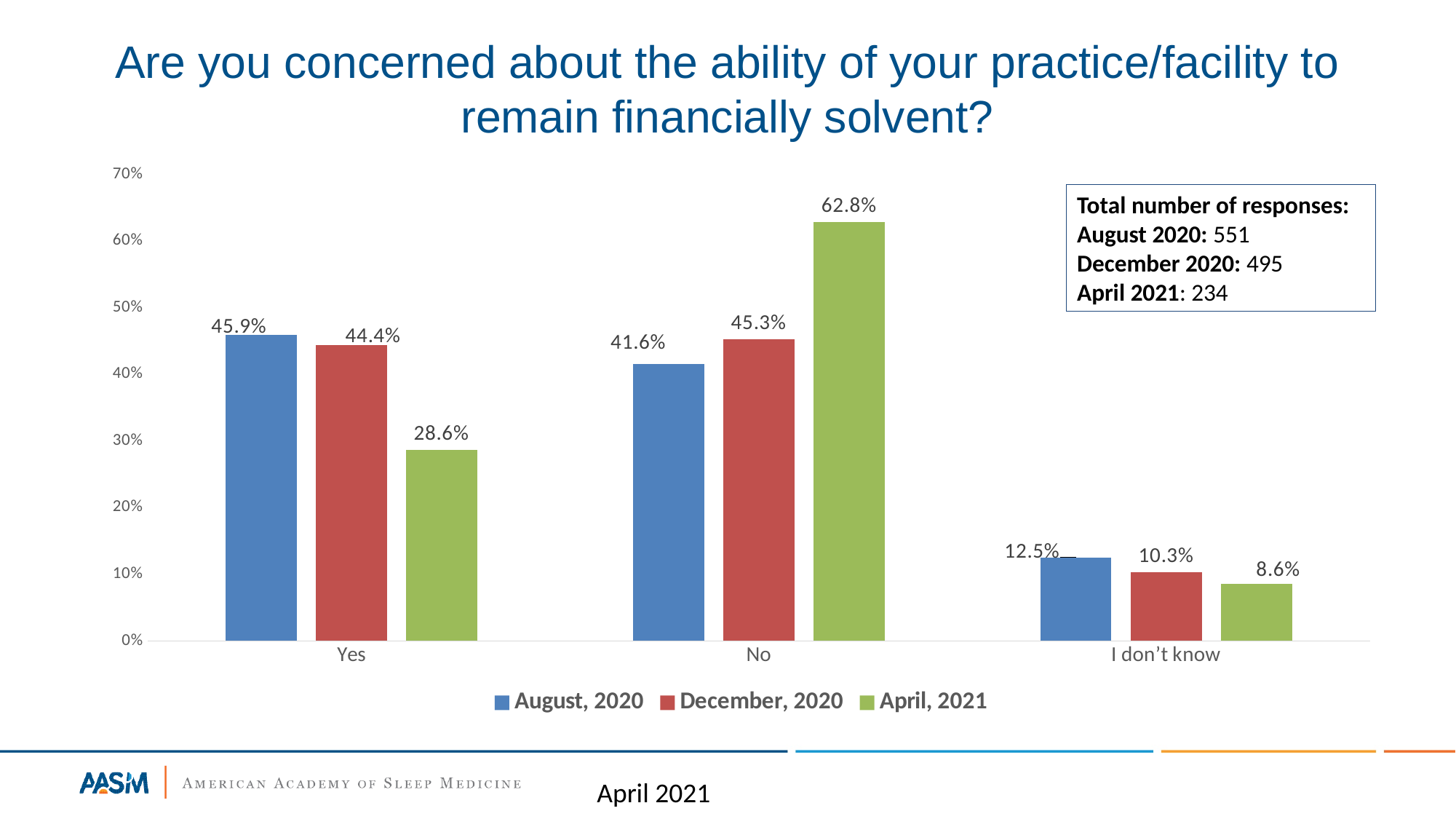
Does the "Yes" value rise or fall from August, 2020 to April, 2021? Fall Which is larger for "Yes": the August, 2020 value or the April, 2021 value? August, 2020 What percentage answered "No" in April, 2021? 62.8% How many response categories are shown on the x axis? 3 Which response category has the highest value for April, 2021? No Which colour represents the April, 2021 series in the legend? Green Which response category has the lowest value for August, 2020? I don't know How many series does the legend list? 3 What kind of chart is shown on the slide? Bar chart What percentage answered "I don't know" in December, 2020? 10.3% What is the difference between the April, 2021 and August, 2020 values for "No"? 21.2% What percentage answered "Yes" in August, 2020? 45.9%